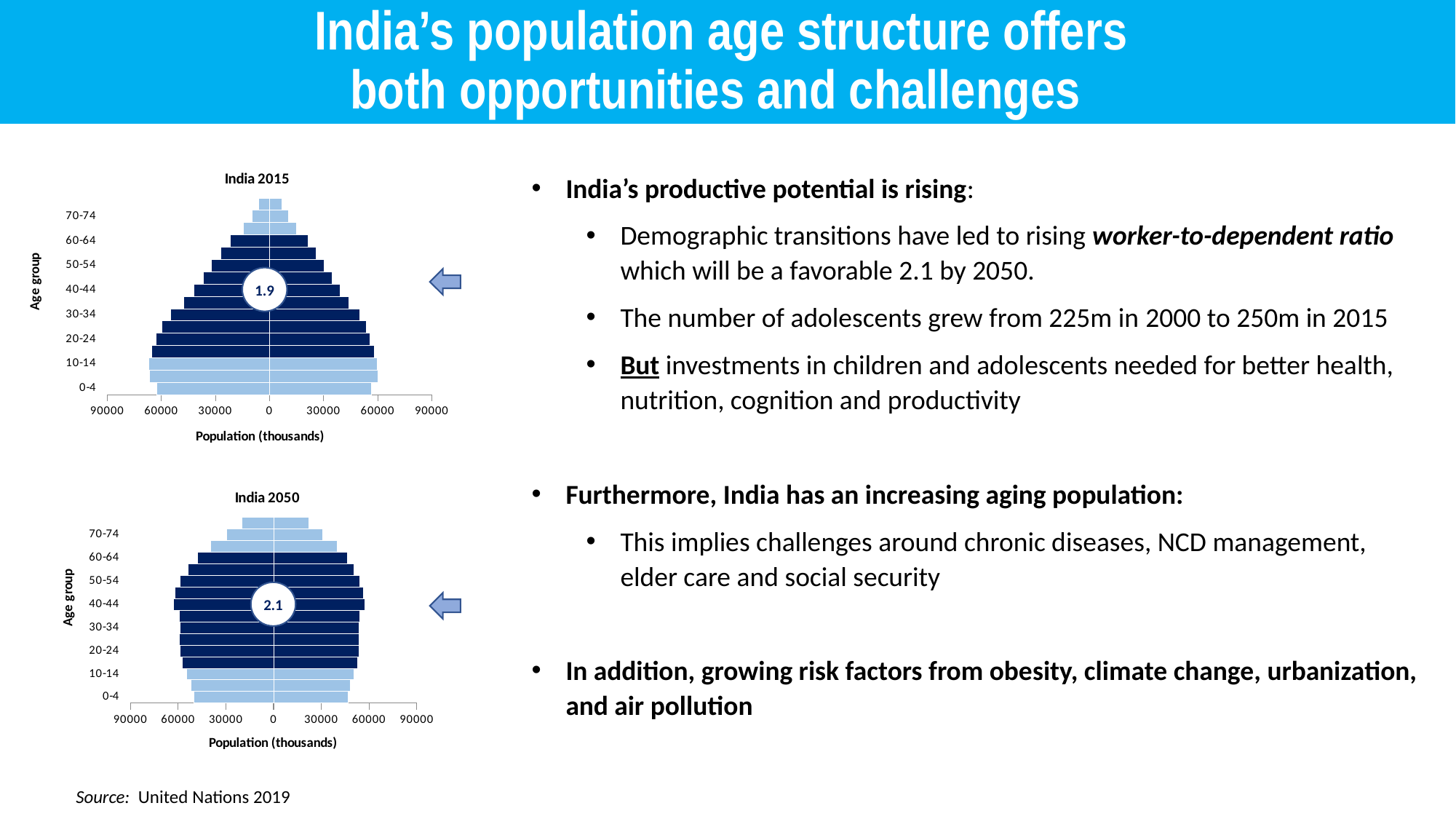
What is the title of the top chart on the slide? India 2015 Which chart shows the larger number in its central circle, India 2015 or India 2050? India 2050 How many age group labels are shown on the y axis of the India 2050 chart? 8 In the India 2015 chart, is the right-hand bar for the 70-74 age group greater or less than 30000? less In the India 2015 chart, what number is printed in the circle at the centre of the pyramid? 1.9 In the India 2015 chart, do the bar lengths generally increase or decrease as the age group gets older? decrease In the India 2050 chart, is the right-hand bar for the 0-4 age group greater or less than 60000? less What kind of chart is the India 2015 chart? bar chart In the India 2050 chart, what number is printed in the circle at the centre of the pyramid? 2.1 In the India 2015 chart, is the right-hand bar for the 0-4 age group greater or less than 30000? greater What is the x-axis title of the India 2050 chart? Population (thousands) In the India 2015 chart, which age group has the longer bars, 0-4 or 70-74? 0-4